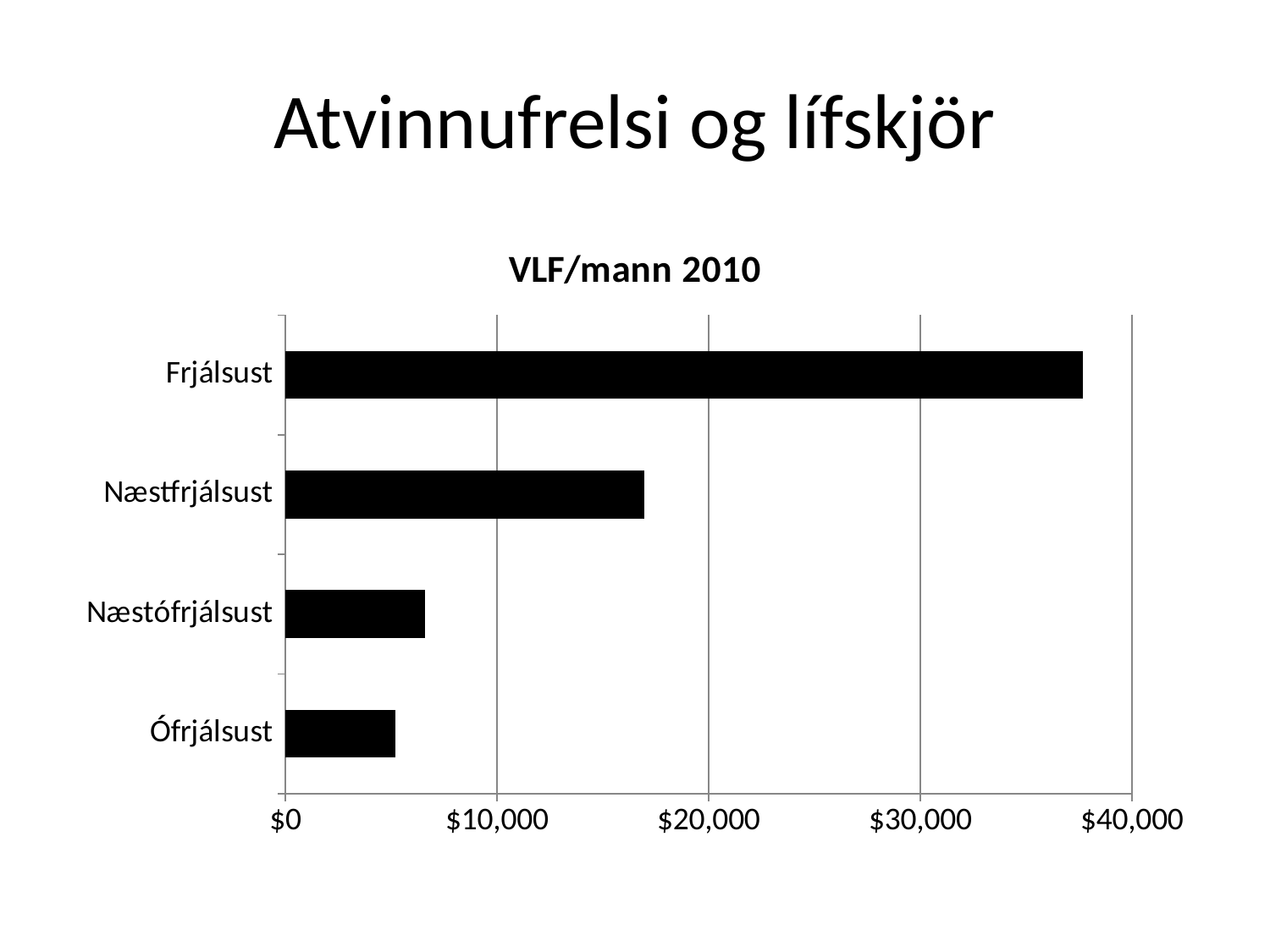
Is the value for Næstfrjálsust greater or less than $10,000? greater What is the title of the chart? VLF/mann 2010 What type of chart is shown on the slide? bar chart Which has a larger value, Ófrjálsust or Frjálsust? Frjálsust Is the value for Næstófrjálsust greater or less than $10,000? less Which has a larger value, Næstfrjálsust or Næstófrjálsust? Næstfrjálsust Which category has the lowest value? Ófrjálsust Is the value for Frjálsust greater or less than $30,000? greater Which category has the highest value? Frjálsust How many categories are shown in the chart? 4